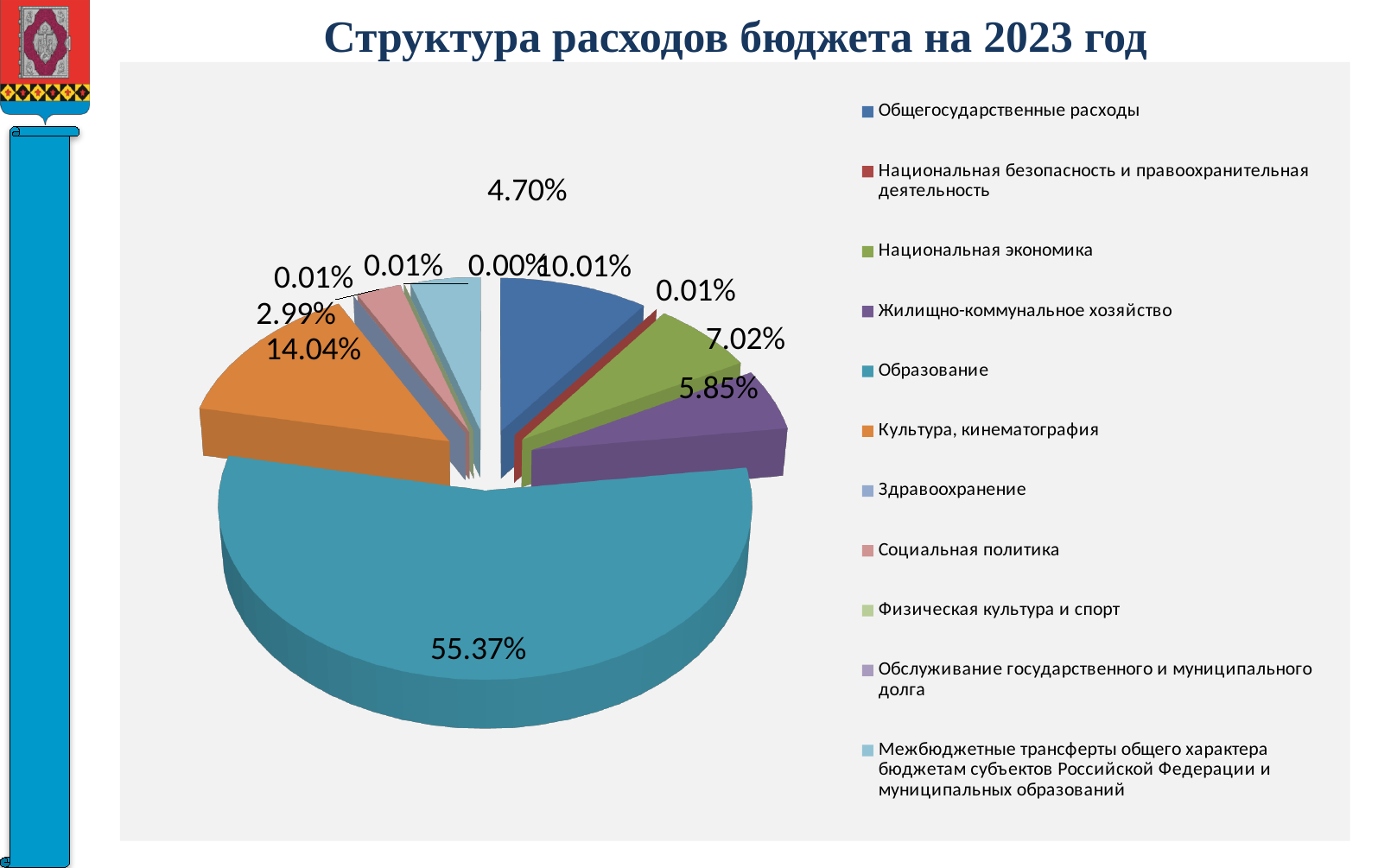
What kind of chart is shown on the slide? pie chart What is the difference between the share for Культура, кинематография and the share for Национальная экономика? 7.02% What is the value shown for Жилищно-коммунальное хозяйство? 5.85% What is the largest percentage label printed on the chart? 55.37% How many categories does the legend list? 11 Which is larger, the share for Культура, кинематография or the share for Национальная экономика? Культура, кинематография Which category has the largest slice of the pie? Образование What share of the budget expenditure goes to Образование? 55.37% What share of the budget expenditure goes to Культура, кинематография? 14.04% What is the title of the chart? Структура расходов бюджета на 2023 год Is the share for Образование greater or less than 50%? greater What is the value shown for Национальная экономика? 7.02%